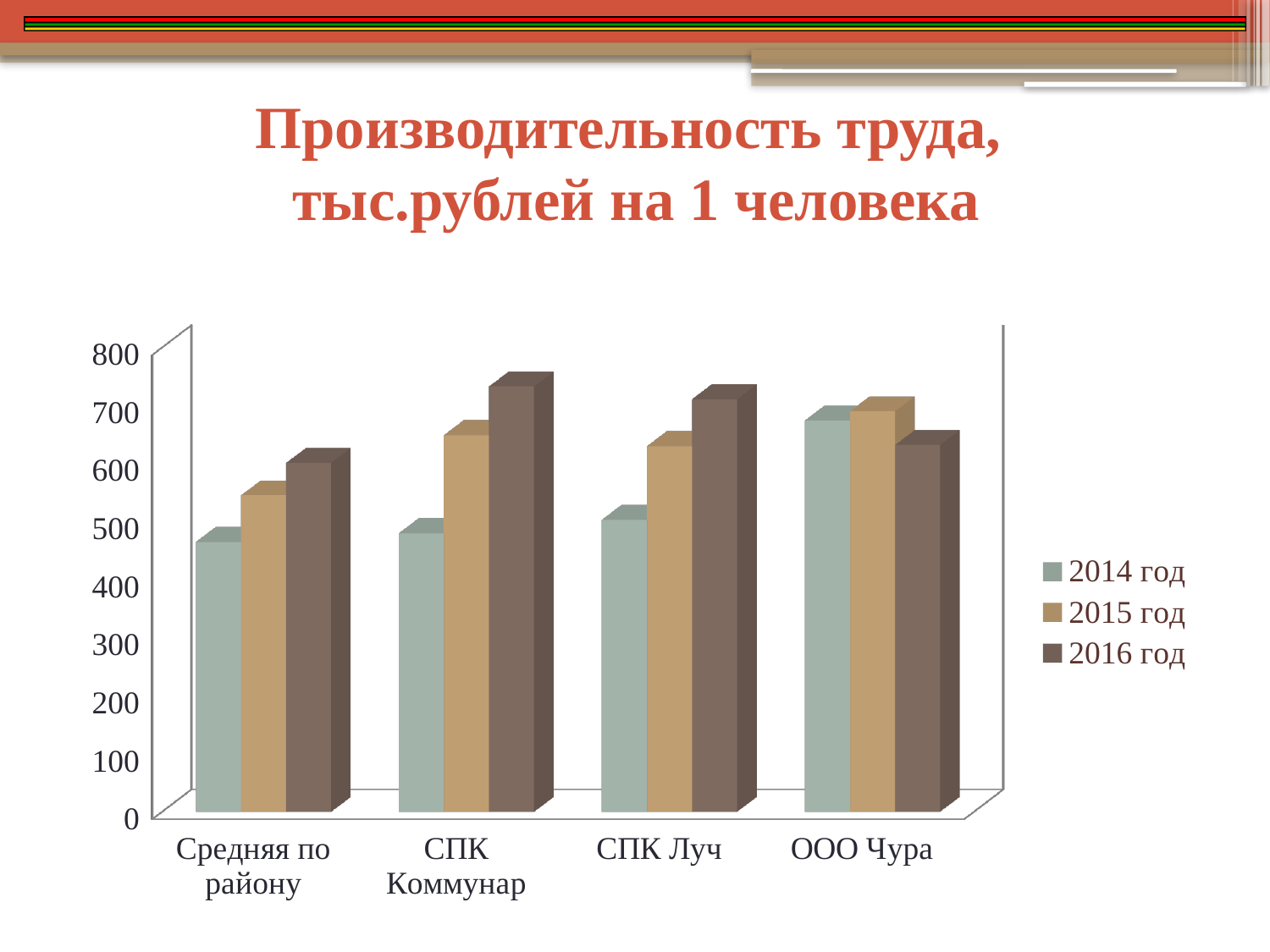
For Средняя по району, do the values rise or fall from 2014 год to 2016 год? rise Is the value for Средняя по району in 2014 год greater or less than 600? less Is the value for СПК Коммунар in 2016 год greater or less than 700? greater Which series are listed in the chart legend? 2014 год, 2015 год, 2016 год For ООО Чура, which is larger: the value for 2015 год or for 2016 год? 2015 год What is the title of the chart on the slide? Производительность труда, тыс.рублей на 1 человека Which category has the lowest value for 2016 год? Средняя по району What kind of chart is shown on the slide? bar chart Is the value for ООО Чура in 2014 год greater or less than 600? greater How many series does the chart legend list? 3 How many categories are shown on the x axis of the chart? 4 Which category has the highest value for 2014 год? ООО Чура